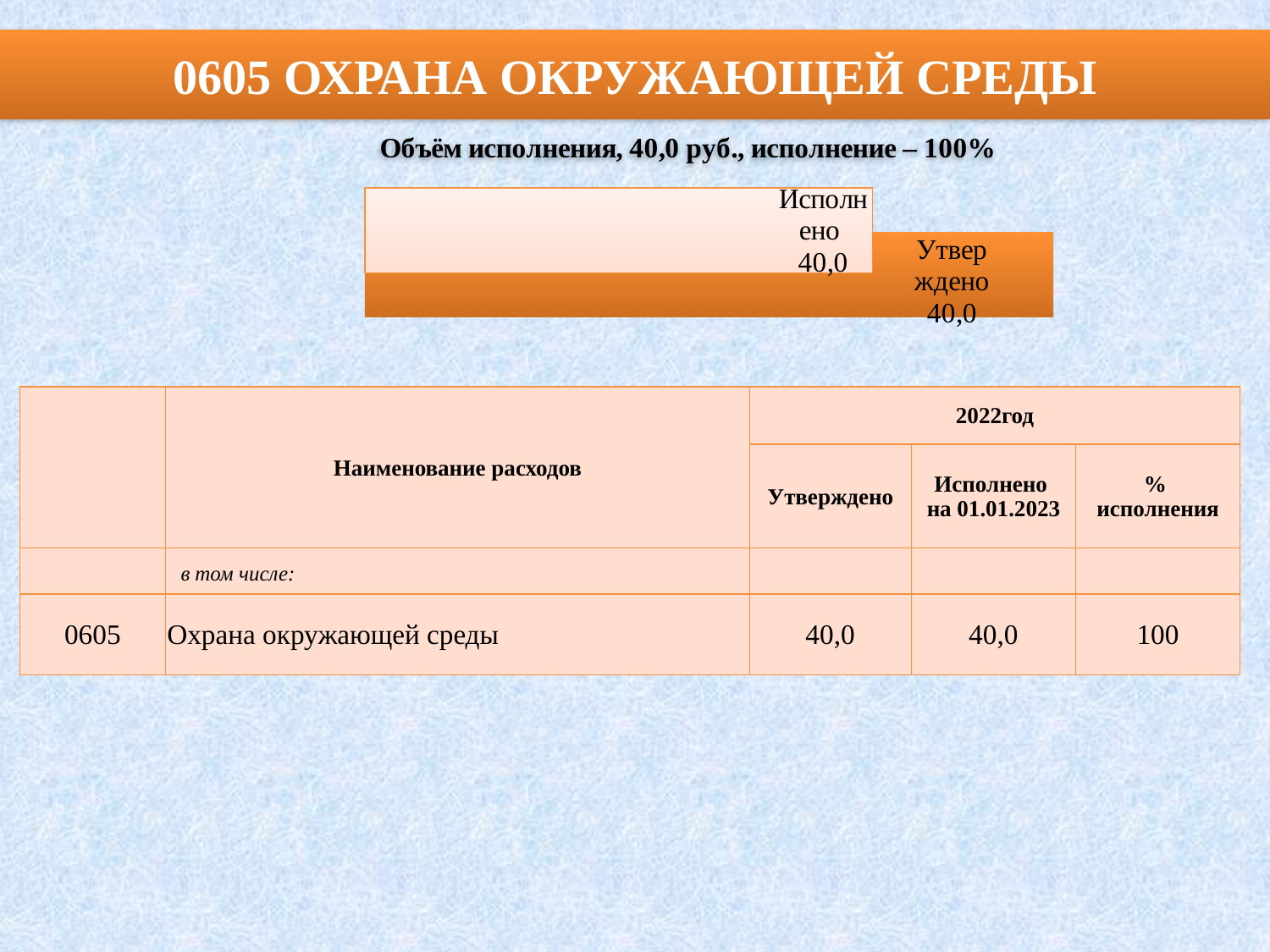
What is the value shown for Утверждено in the chart? 40,0 How many bars are plotted in the chart? 2 What is the difference between the Утверждено and Исполнено values in the chart? 0,0 Which bar in the chart is drawn in a pale, light colour? Исполнено Are the Утверждено and Исполнено values in the chart equal or different? equal What kind of chart is shown on the slide? bar chart Are the bars in the chart horizontal or vertical? horizontal What is the value shown for Исполнено in the chart? 40,0 Which bar in the chart is drawn in dark orange? Утверждено